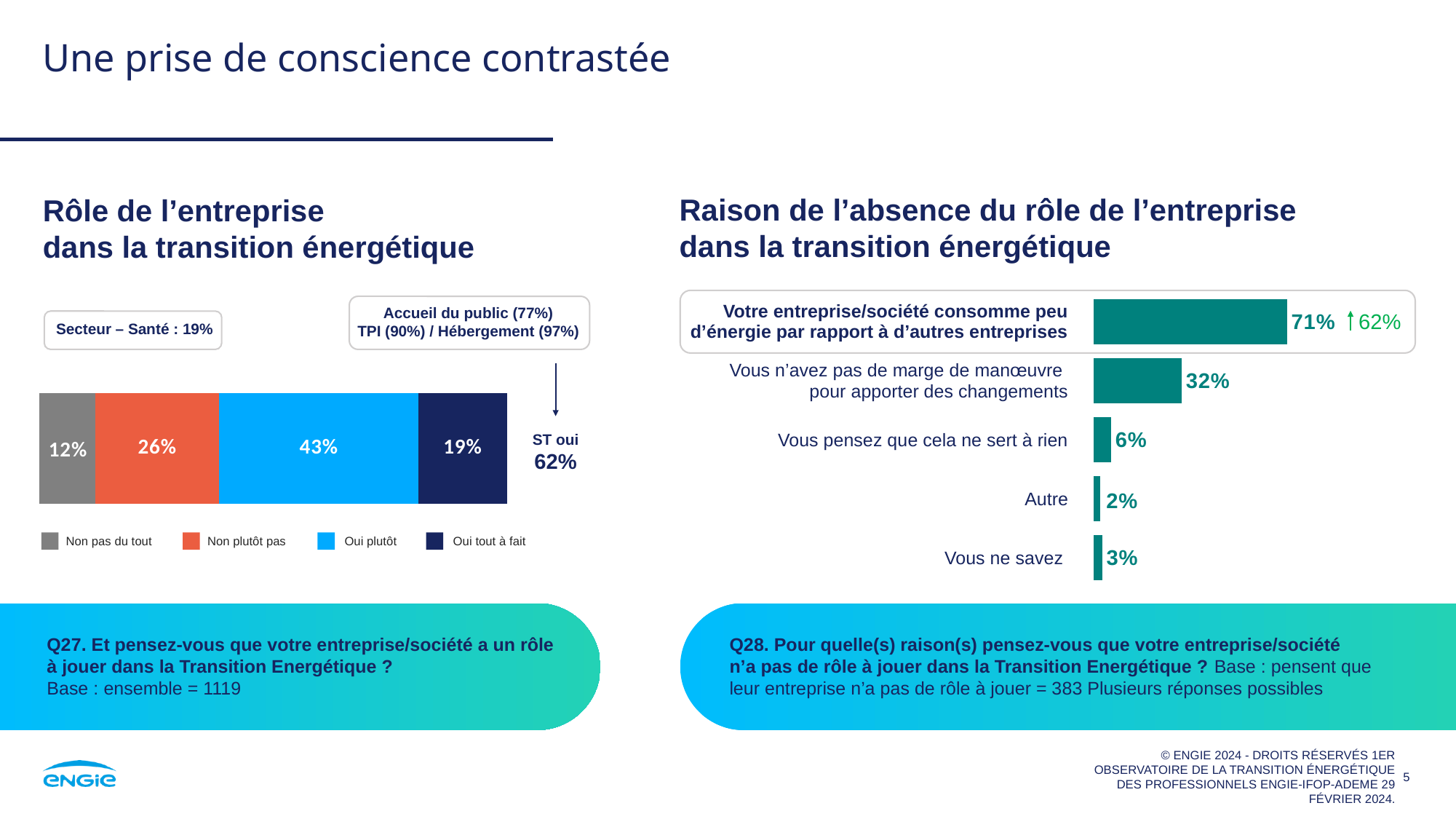
In the chart 'Rôle de l'entreprise dans la transition énergétique', what is the value for 'Non pas du tout'? 12% In the chart 'Raison de l'absence du rôle de l'entreprise dans la transition énergétique', how many categories are shown? 5 In the chart 'Rôle de l'entreprise dans la transition énergétique', how many series does the legend list? 4 What kind of chart is 'Raison de l'absence du rôle de l'entreprise dans la transition énergétique'? Bar chart In the chart 'Rôle de l'entreprise dans la transition énergétique', what is the value for 'Oui plutôt'? 43% In the chart 'Raison de l'absence du rôle de l'entreprise dans la transition énergétique', what is the value for 'Vous n'avez pas de marge de manœuvre pour apporter des changements'? 32% In the chart 'Rôle de l'entreprise dans la transition énergétique', what is the total of 'Oui plutôt' and 'Oui tout à fait'? 62% In the chart 'Raison de l'absence du rôle de l'entreprise dans la transition énergétique', which category has the highest value? Votre entreprise/société consomme peu d'énergie par rapport à d'autres entreprises In the chart 'Raison de l'absence du rôle de l'entreprise dans la transition énergétique', what is the difference between the top reason (71%) and 'Vous n'avez pas de marge de manœuvre pour apporter des changements'? 39% In the chart 'Rôle de l'entreprise dans la transition énergétique', which category has the highest value? Oui plutôt In the chart 'Rôle de l'entreprise dans la transition énergétique', what is the difference between 'Non plutôt pas' and 'Oui tout à fait'? 7% In the chart 'Raison de l'absence du rôle de l'entreprise dans la transition énergétique', which category has the lowest value? Autre